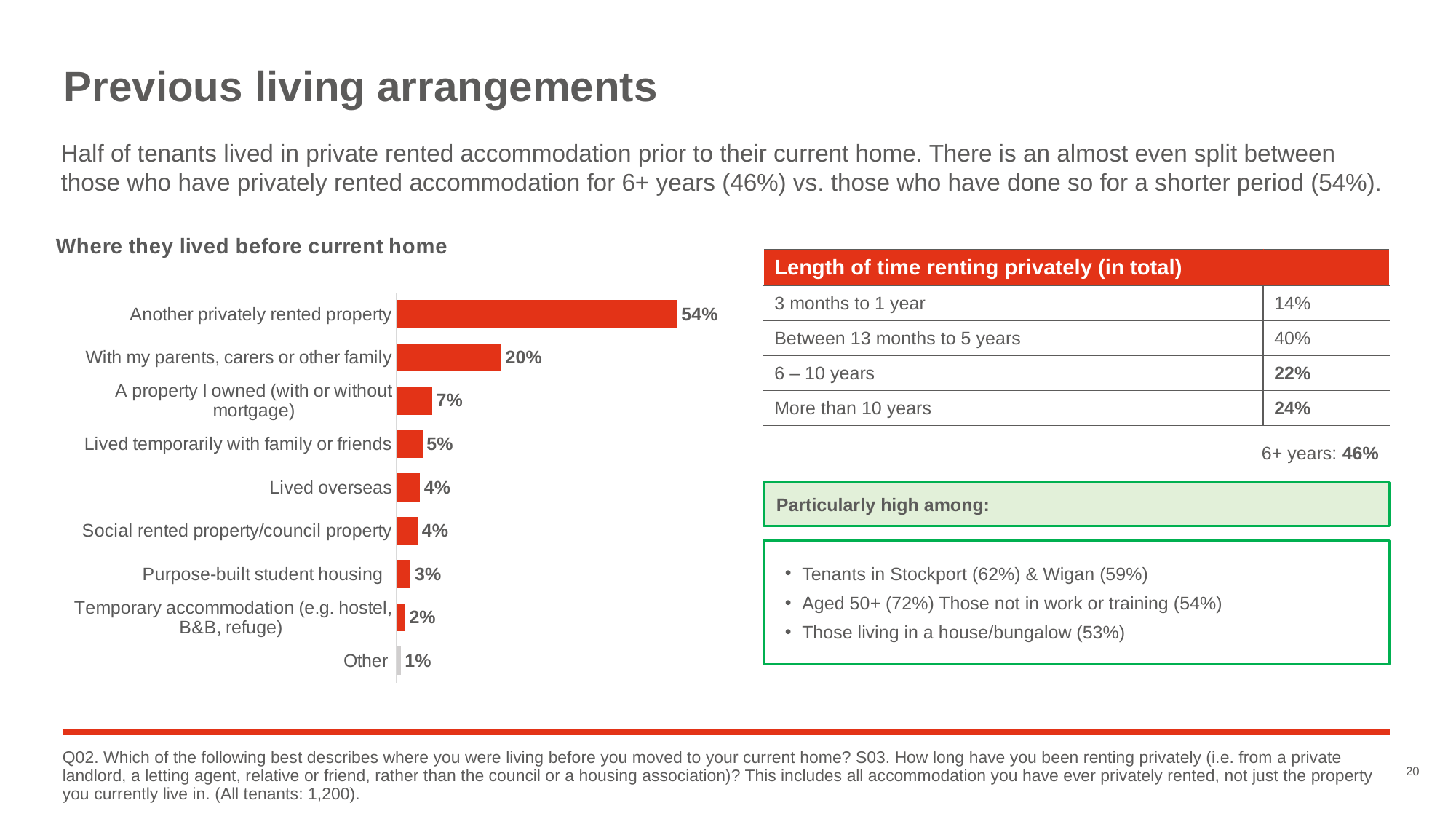
How many categories are shown in the bar chart? 9 What is the difference between 'A property I owned (with or without mortgage)' and 'Lived temporarily with family or friends'? 2% What is the title of the bar chart? Where they lived before current home What is the value for 'Purpose-built student housing'? 3% What kind of chart is 'Where they lived before current home'? bar chart What is the value for 'With my parents, carers or other family'? 20% Which category has the highest value? Another privately rented property Which is larger: 'Lived overseas' or 'Purpose-built student housing'? Lived overseas What is the value for 'Temporary accommodation (e.g. hostel, B&B, refuge)'? 2% What is the value for 'Another privately rented property'? 54% What is the difference between 'Another privately rented property' and 'With my parents, carers or other family'? 34% Which category has the lowest value? Other